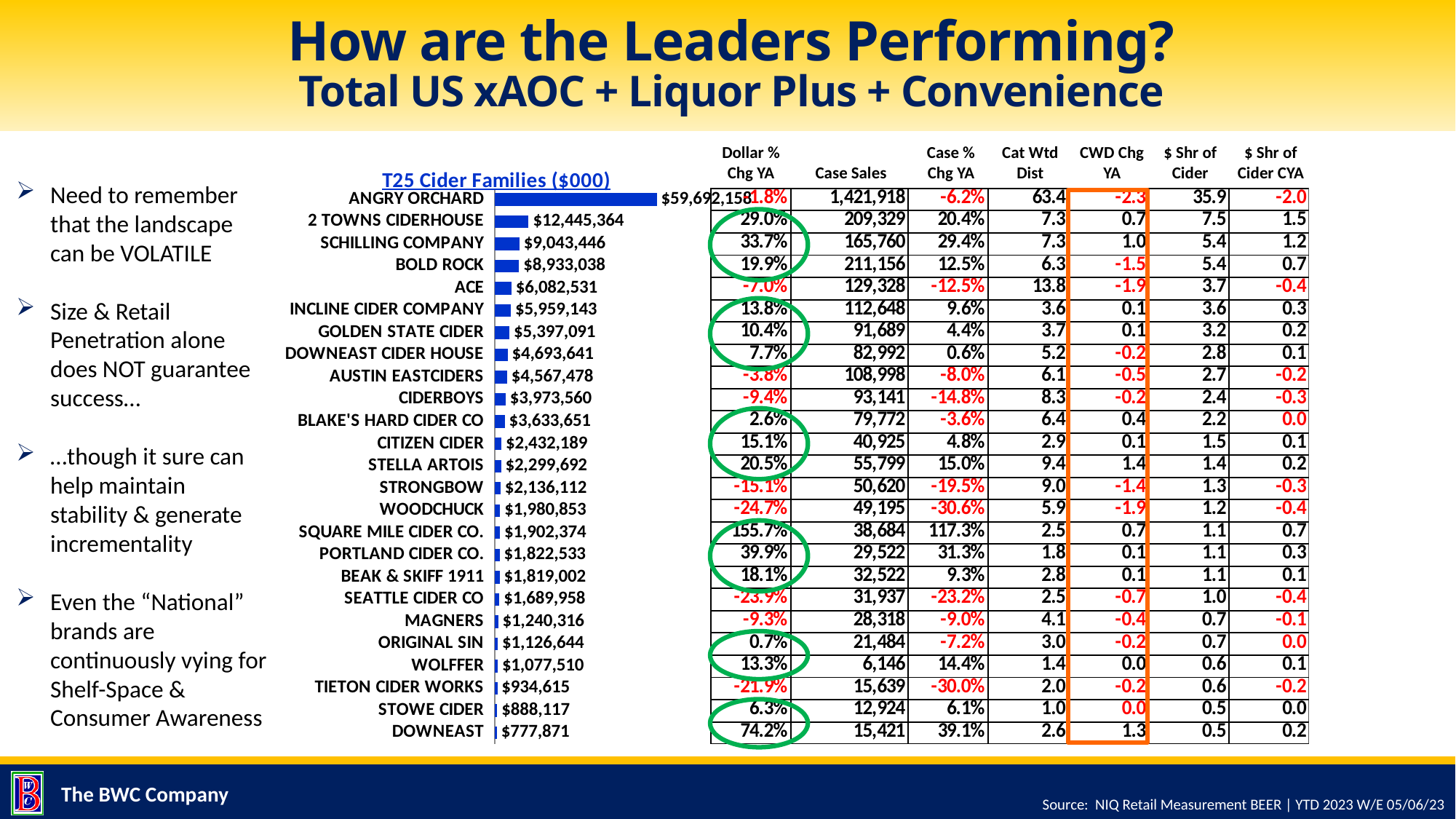
What is the value shown for Stowe Cider? $888,117 Do the bar values rise or fall going from the top of the chart to the bottom? fall Which cider family has the smallest bar in the chart? Downeast How many cider families are plotted in the chart? 25 What is the value shown for 2 Towns Ciderhouse? $12,445,364 What is the value shown for Woodchuck? $1,980,853 What kind of chart is shown on the slide? bar chart What is the value shown for Bold Rock? $8,933,038 What is the difference between the values for 2 Towns Ciderhouse and Schilling Company? $3,401,918 What is the title of the chart? T25 Cider Families ($000) Which cider family has the largest bar in the chart? Angry Orchard Which has a larger value, Stella Artois or Strongbow? Stella Artois